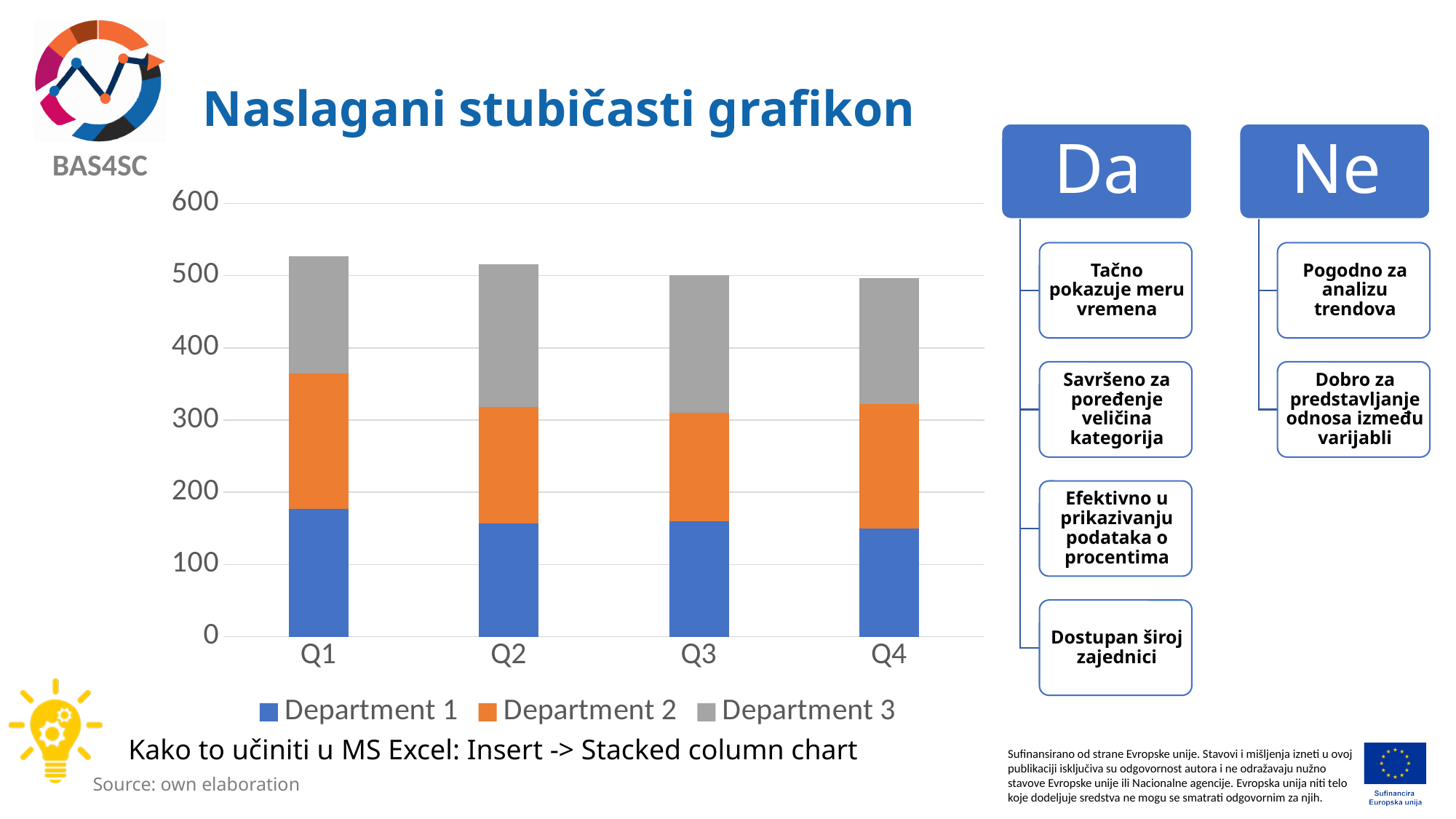
Is the value for Department 1 in Q1 greater or less than 100? greater How many series does the chart legend list? 3 Is the value for Department 1 in Q4 greater or less than 200? less How many categories are shown on the x axis of the chart? 4 Which is larger, the Department 2 segment in Q1 or the Department 2 segment in Q2? Q1 Which is larger, the Department 1 value in Q1 or the Department 1 value in Q4? Q1 Is the total height of the Q1 stacked bar greater or less than 500? greater Which colour represents Department 2 in the chart? Orange What kind of chart is shown on the slide? Stacked bar chart What is the title of the slide containing the chart? Naslagani stubičasti grafikon